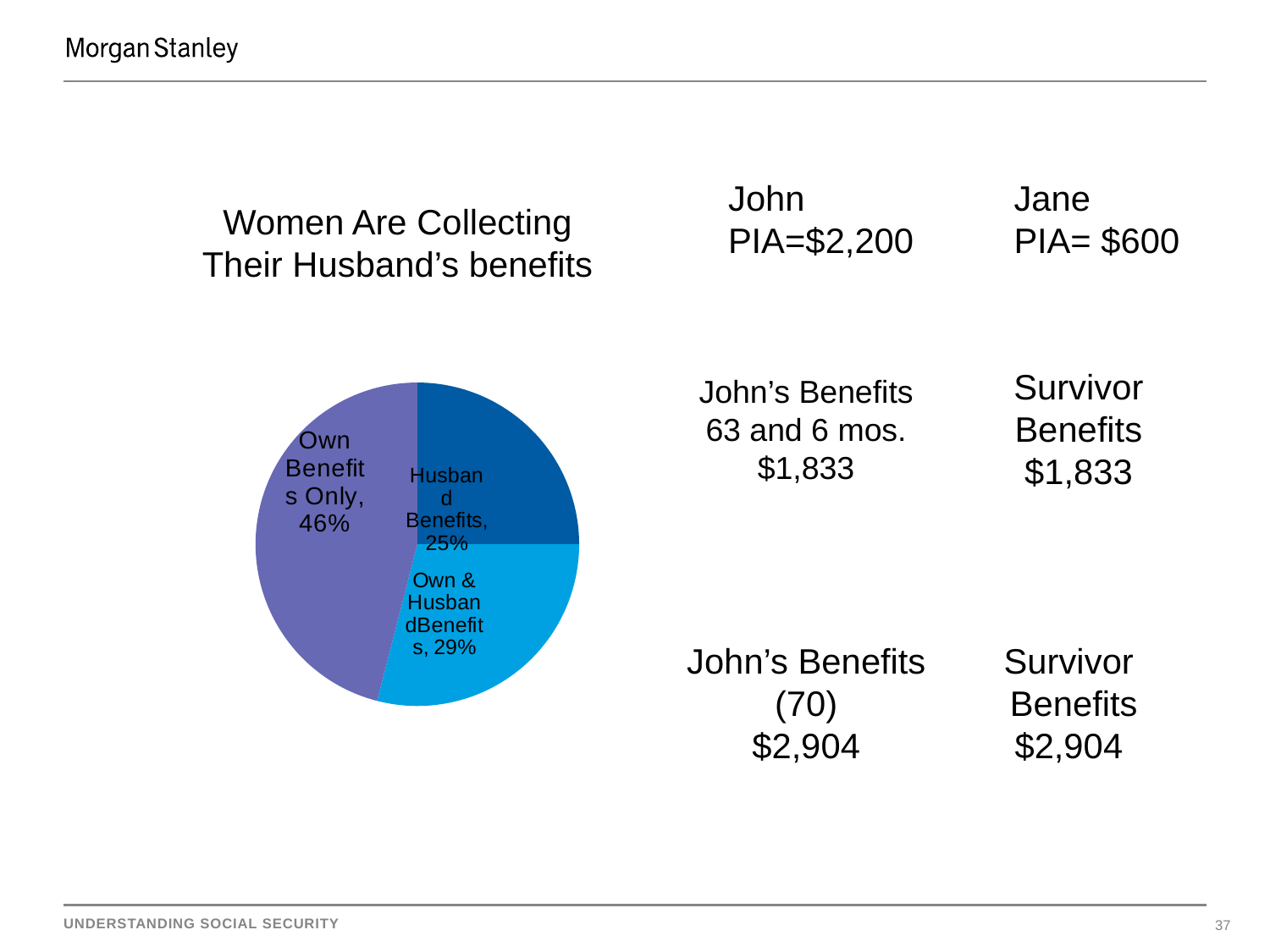
What is the combined share of the "Husband Benefits" and "Own & Husband Benefits" slices? 54% What is the title of the pie chart? Women Are Collecting Their Husband's benefits What share of the pie is labelled "Own Benefits Only"? 46% What is the difference in percentage points between the "Own & Husband Benefits" slice and the "Husband Benefits" slice? 4 What is the difference in percentage points between the "Own Benefits Only" slice and the "Husband Benefits" slice? 21 Which is larger, the "Own & Husband Benefits" slice or the "Husband Benefits" slice? Own & Husband Benefits Which slice of the pie is the smallest? Husband Benefits What kind of chart is shown on the slide? pie chart What share of the pie is labelled "Husband Benefits"? 25% What share of the pie is labelled "Own & Husband Benefits"? 29% Which slice of the pie is the largest? Own Benefits Only How many slices does the pie chart have? 3